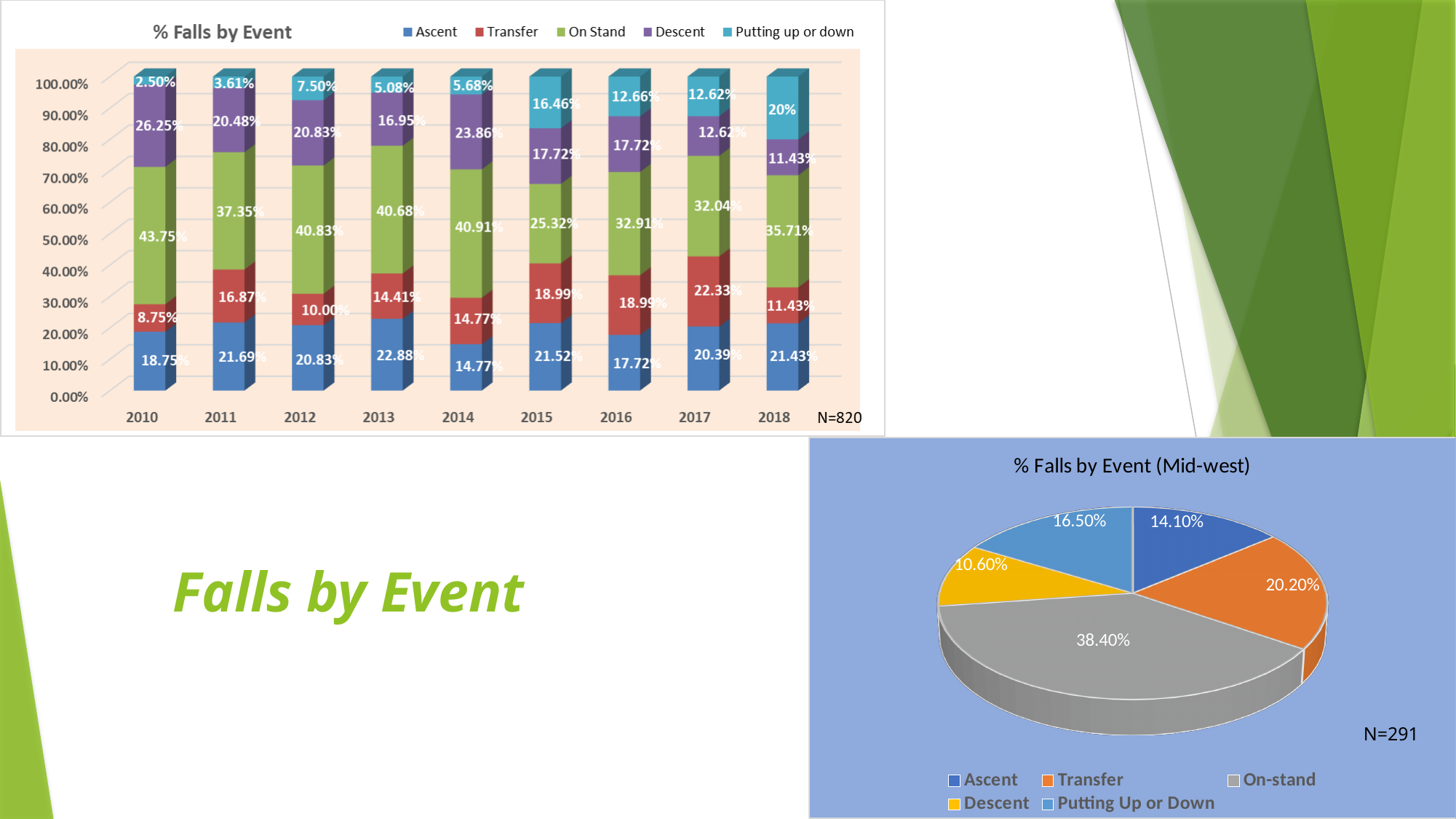
In the '% Falls by Event' bar chart, which year has the lowest Ascent value? 2014 In the '% Falls by Event' bar chart, which year has the highest Putting up or down value? 2018 In the '% Falls by Event' bar chart, which is larger: the On Stand value for 2015 or for 2016? 2016 In the '% Falls by Event (Mid-west)' pie chart, which category has the smallest slice? Descent In the '% Falls by Event' bar chart, what is the Transfer value for 2017? 22.33% In the '% Falls by Event' bar chart, what is the Putting up or down value for 2018? 20% In the '% Falls by Event' bar chart, what is the difference between the Descent values for 2010 and 2018? 14.82% What kind of chart is '% Falls by Event (Mid-west)'? Pie chart In the '% Falls by Event' bar chart, what is the On Stand value for 2010? 43.75% How many series does the legend of the '% Falls by Event' bar chart list? 5 How many years are shown on the x axis of the '% Falls by Event' bar chart? 9 In the '% Falls by Event (Mid-west)' pie chart, what share is On-stand? 38.40%